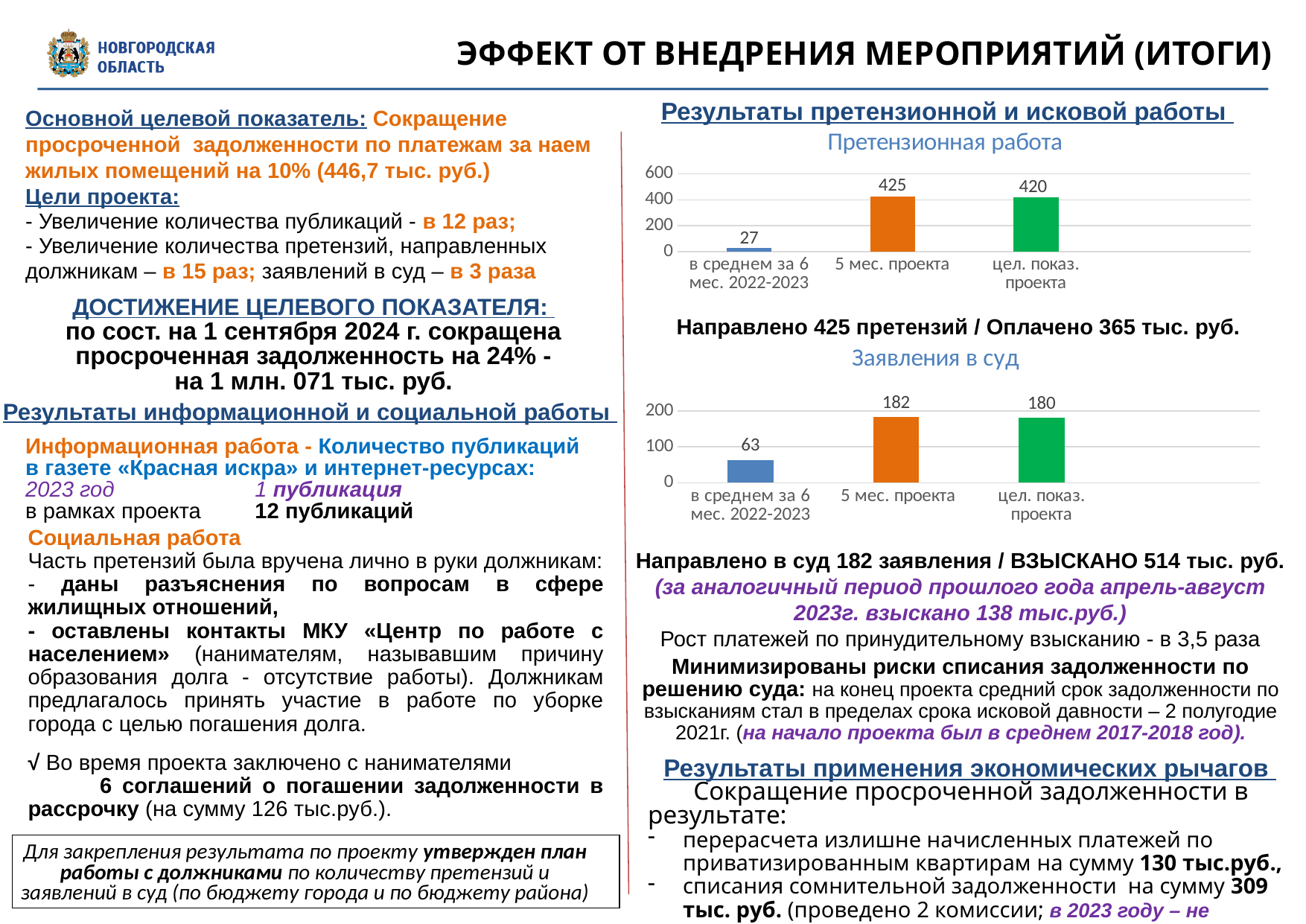
In the chart titled "Претензионная работа", which category has the highest value? 5 мес. проекта In the chart titled "Претензионная работа", what is the value for "в среднем за 6 мес. 2022-2023"? 27 In the chart titled "Претензионная работа", what is the value for "5 мес. проекта"? 425 In the chart titled "Заявления в суд", what is the difference between the values for "5 мес. проекта" and "в среднем за 6 мес. 2022-2023"? 119 In the chart titled "Заявления в суд", which is larger: the value for "5 мес. проекта" or the value for "в среднем за 6 мес. 2022-2023"? 5 мес. проекта In the chart titled "Претензионная работа", which category has the lowest value? в среднем за 6 мес. 2022-2023 In the chart titled "Заявления в суд", what is the value for "5 мес. проекта"? 182 In the chart titled "Заявления в суд", which category has the lowest value? в среднем за 6 мес. 2022-2023 What kind of chart is the chart titled "Заявления в суд"? bar chart In the chart titled "Претензионная работа", what is the difference between the values for "5 мес. проекта" and "в среднем за 6 мес. 2022-2023"? 398 How many categories are shown in the chart titled "Претензионная работа"? 3 In the chart titled "Заявления в суд", what is the value for "цел. показ. проекта"? 180